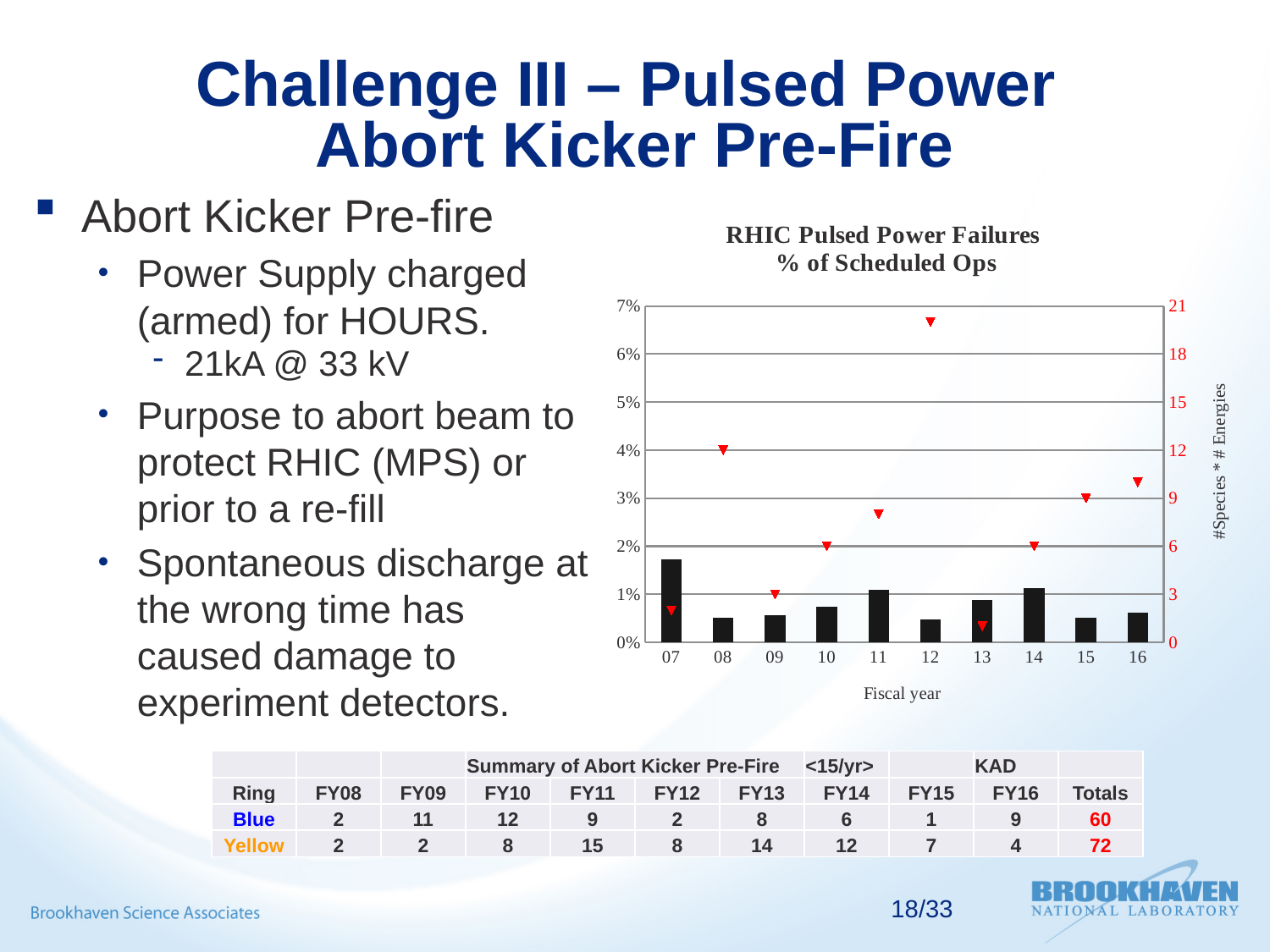
Which fiscal year has the tallest bar in the chart? 07 How many fiscal years are plotted along the x axis of the chart? 10 What is the title of the chart on the slide? RHIC Pulsed Power Failures % of Scheduled Ops What kind of chart is shown on the slide? bar chart Which fiscal year has the higher bar, 10 or 11? 11 What is the label of the x axis of the chart? Fiscal year Is the red triangle marker for fiscal year 12 greater or less than 18 on the right axis? greater Is the bar for fiscal year 07 greater or less than 1%? greater Is the bar for fiscal year 10 greater or less than 1%? less Which fiscal year has the higher bar, 07 or 14? 07 Which fiscal year has the highest red triangle marker (#Species * # Energies) in the chart? 12